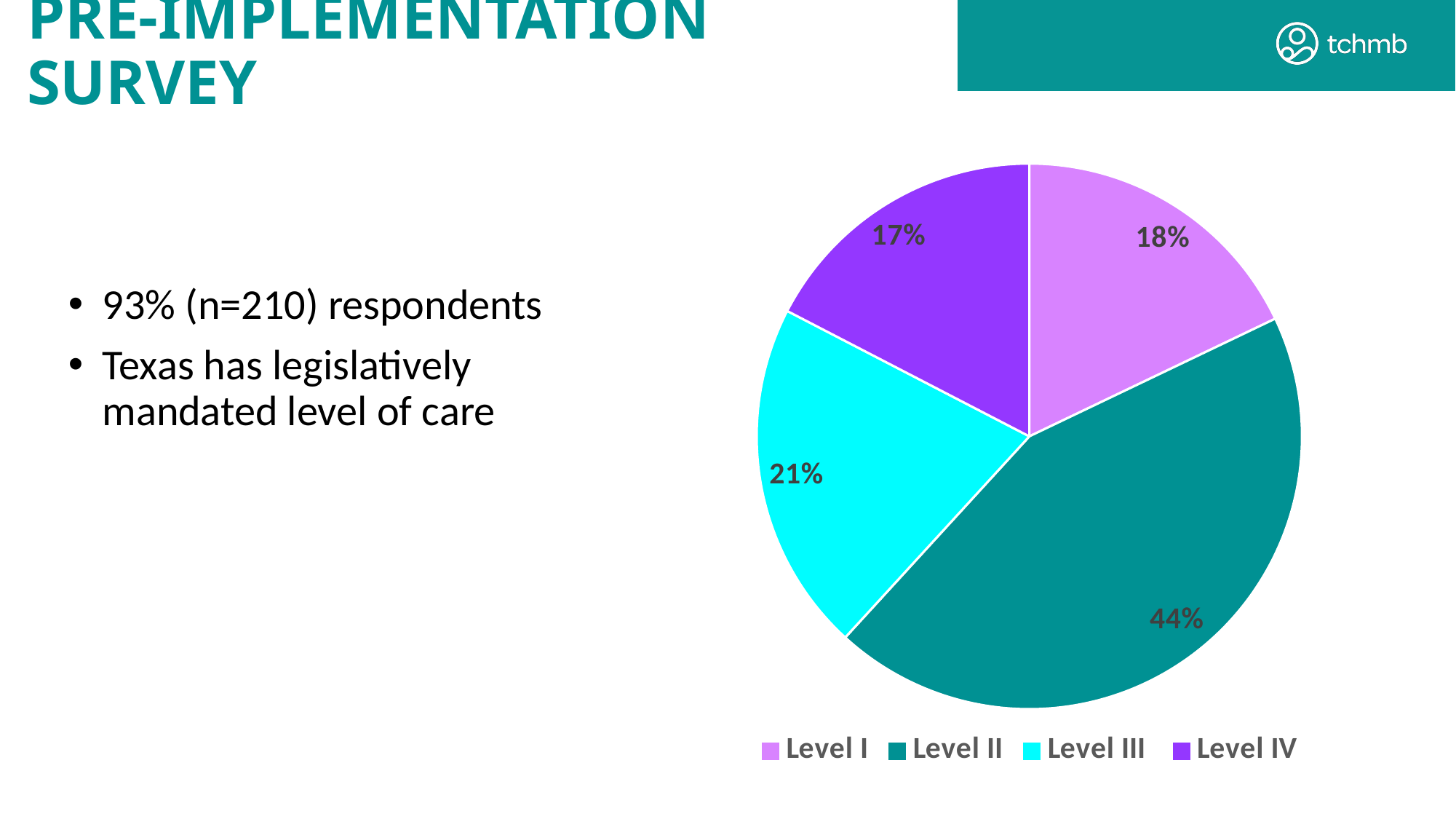
Which level has the largest share of the pie? Level II Which level has the smallest share of the pie? Level IV What percentage of the pie is Level IV? 17% How many entries does the legend list? 4 Which is larger, the share for Level III or the share for Level I? Level III How many slices does the pie chart have? 4 What percentage of the pie is Level III? 21% What is the difference in percentage points between Level II and Level III? 23 What kind of chart is shown on the slide? pie chart What percentage of the pie is Level I? 18% What colour is the Level II slice? teal What percentage of the pie is Level II? 44%